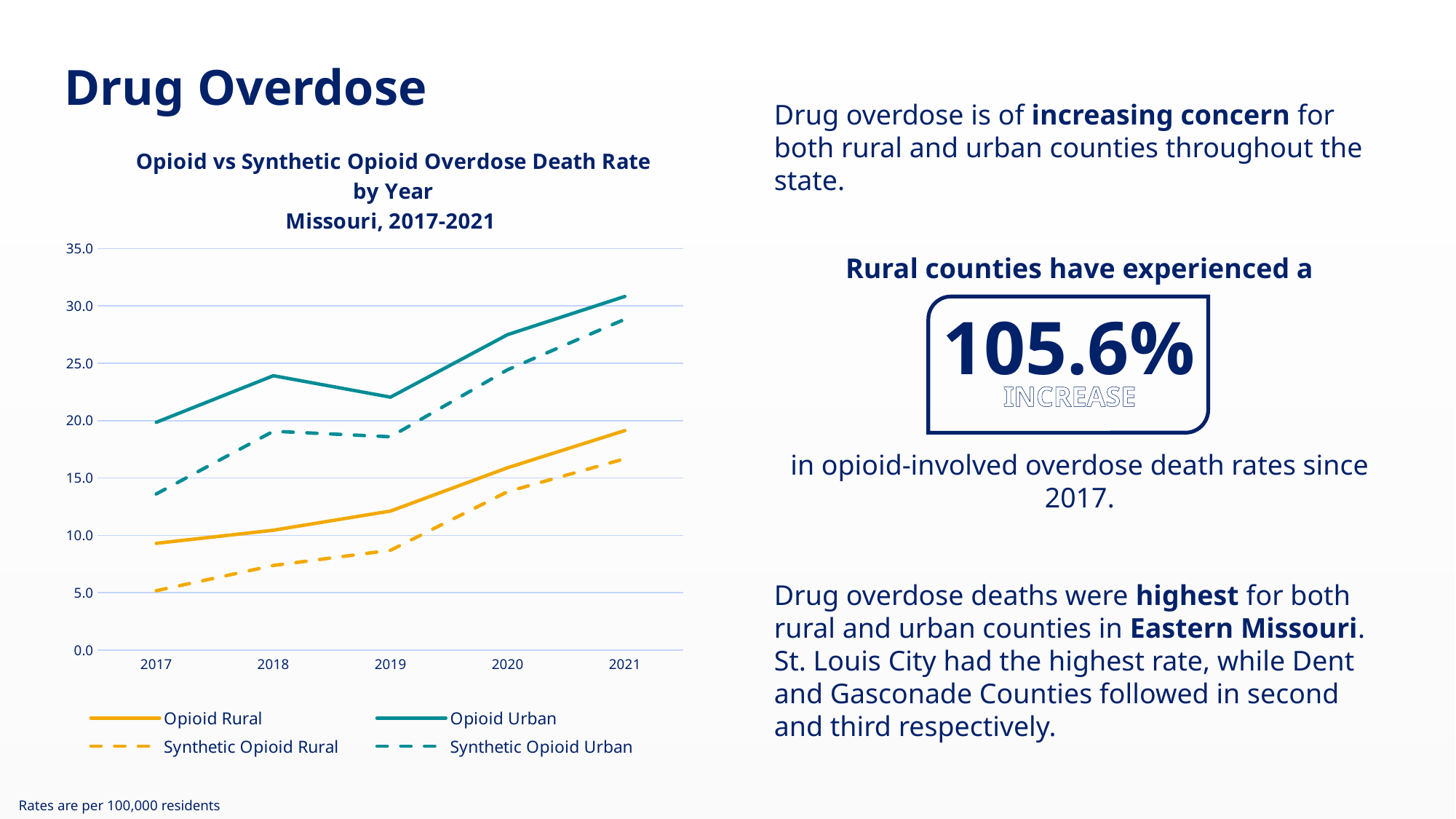
Is the value for Opioid Rural in 2017 greater or less than 10.0? less For the Opioid Urban series, which year has the larger value, 2018 or 2019? 2018 What kind of chart is shown on the slide? line chart Are the Synthetic Opioid series drawn with solid or dashed lines? dashed Which series has the highest value in 2021? Opioid Urban What is the title of the chart? Opioid vs Synthetic Opioid Overdose Death Rate by Year Missouri, 2017-2021 Does the Opioid Rural series rise or fall from 2017 to 2021? rise Which series has the lowest value in 2017? Synthetic Opioid Rural Is the value for Opioid Urban in 2021 greater or less than 30.0? greater How many series does the legend of the chart list? 4 How many years are plotted along the x axis of the chart? 5 Is the value for Synthetic Opioid Rural in 2021 greater or less than 15.0? greater